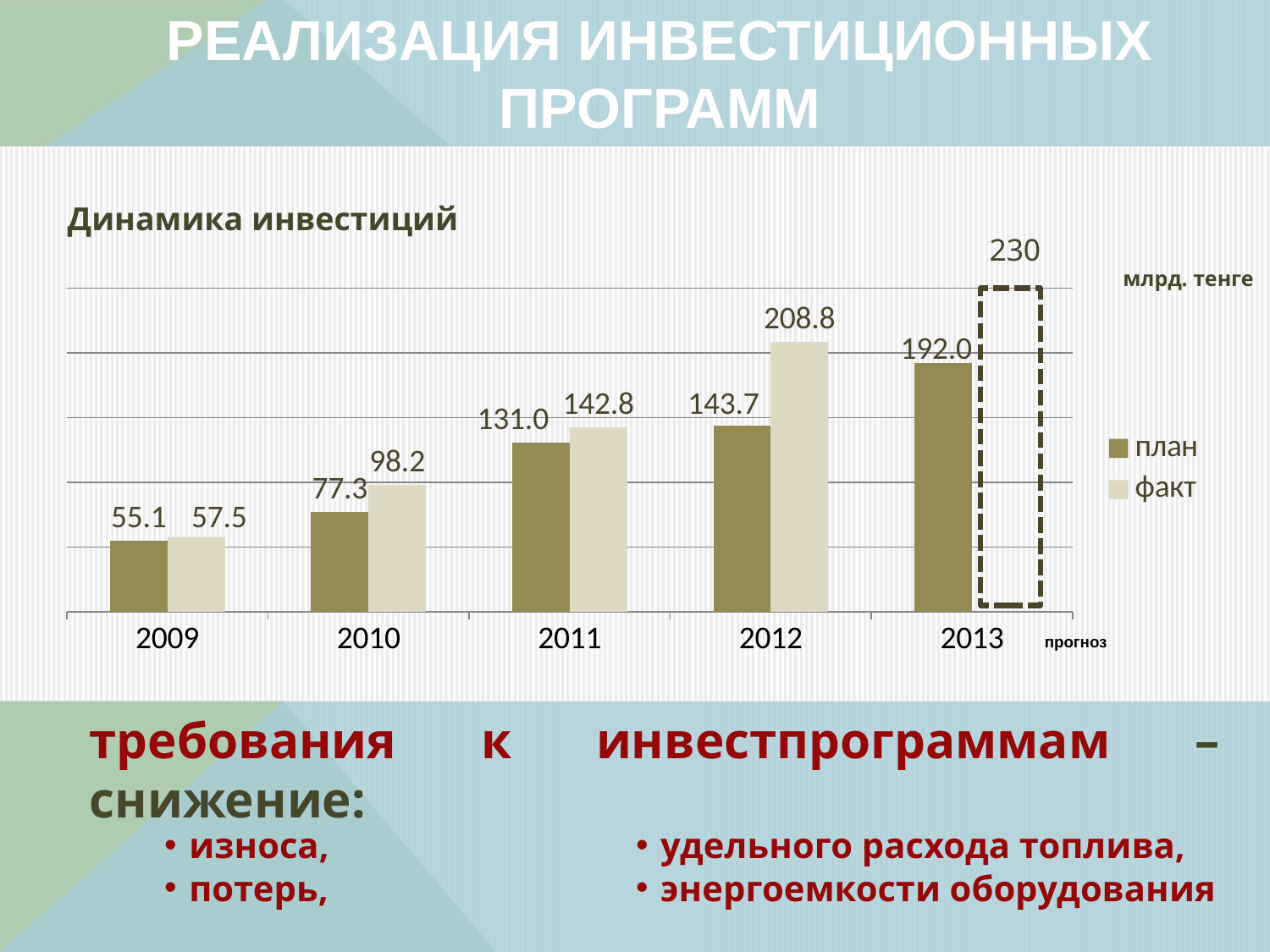
What is the факт value for 2012 in the Динамика инвестиций chart? 208.8 Which year has the highest факт value among the labelled факт bars in the Динамика инвестиций chart? 2012 What is the план value for 2011 in the Динамика инвестиций chart? 131.0 What is the факт value for 2009 in the Динамика инвестиций chart? 57.5 Do the план values rise or fall from 2009 to 2013 in the Динамика инвестиций chart? rise How many series does the legend of the Динамика инвестиций chart list? 2 What kind of chart is the Динамика инвестиций chart? bar chart Which year has the lowest план value in the Динамика инвестиций chart? 2009 What is the difference between the факт and план values for 2012 in the Динамика инвестиций chart? 65.1 What is the план value for 2013 in the Динамика инвестиций chart? 192.0 What is the difference between the факт and план values for 2010 in the Динамика инвестиций chart? 20.9 In the Динамика инвестиций chart, which is larger: the план value for 2013 or the факт value for 2012? факт value for 2012